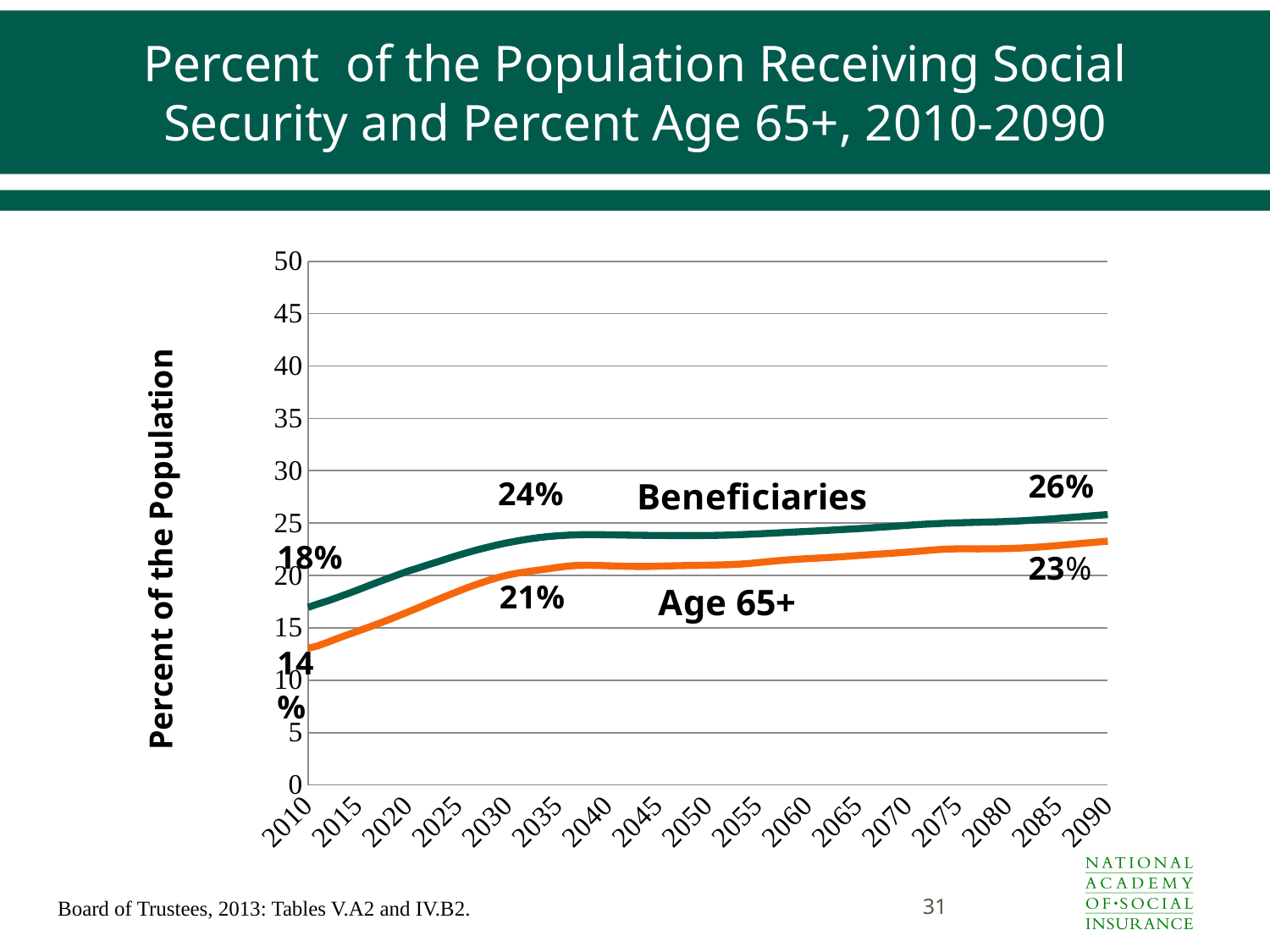
Do the Beneficiaries values generally rise or fall from 2010 to 2090? rise Which series is higher in 2090, Beneficiaries or Age 65+? Beneficiaries How many lines (series) are plotted on the chart? 2 Is the value for Age 65+ in 2020 greater or less than 20? less What is the label on the vertical axis? Percent of the Population What is the value for Age 65+ in 2090? 23% What kind of chart is shown on the slide? line chart What is the difference between the Beneficiaries value and the Age 65+ value in 2010? 4 percentage points What is the difference between the Beneficiaries value and the Age 65+ value in 2090? 3 percentage points What is the value for Age 65+ in 2010? 14% What is the value for Beneficiaries in 2090? 26% What is the value for Beneficiaries in 2010? 18%